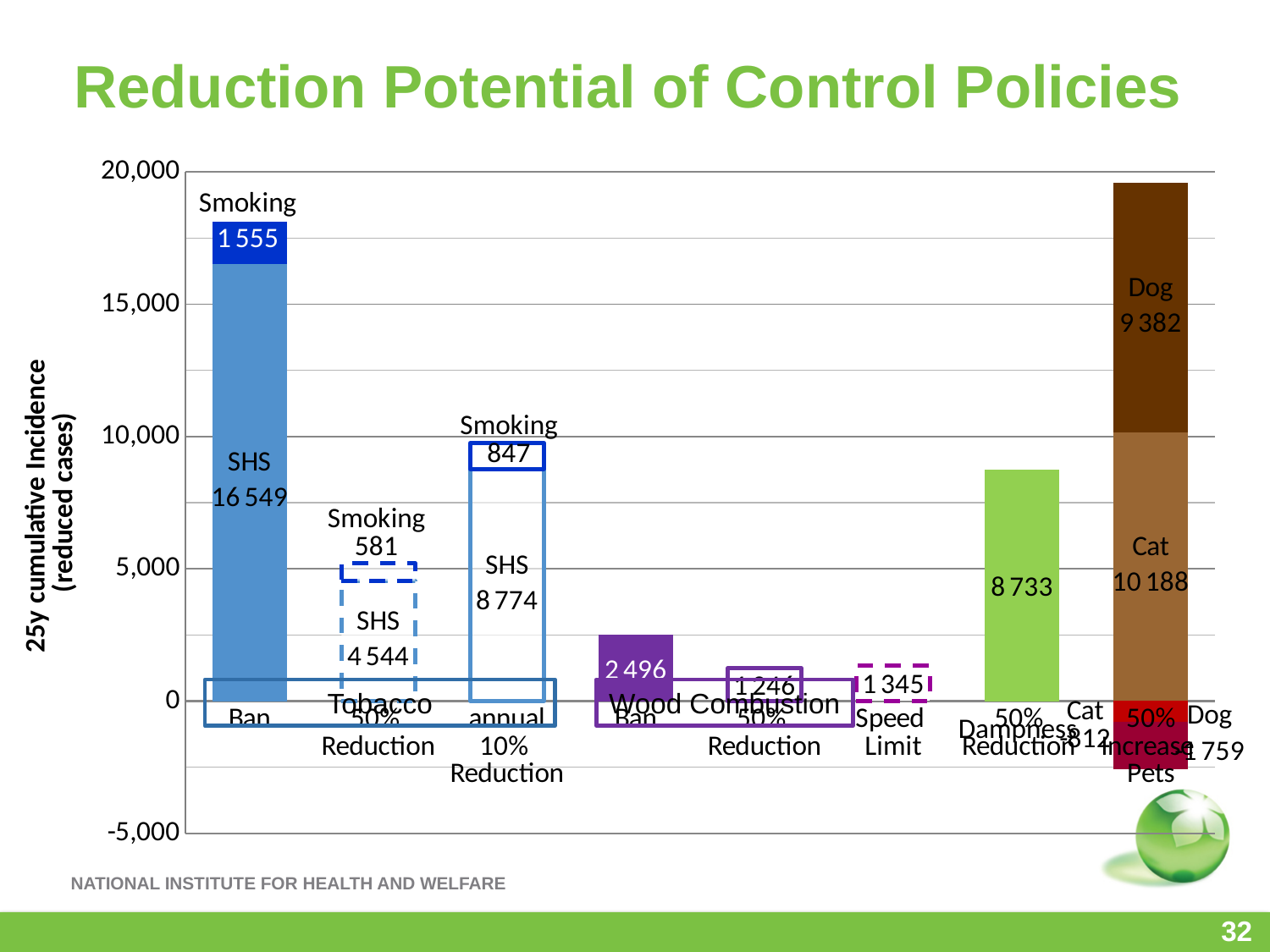
Is the value for Dampness 50% Reduction greater or less than 5,000? greater What is the difference between the SHS value for Tobacco Ban and the SHS value for Tobacco annual 10% Reduction? 7 775 What is the Smoking value for the Tobacco Ban bar? 1 555 What is the value for Dampness 50% Reduction? 8 733 What is the Smoking value for the Tobacco annual 10% Reduction bar? 847 What is the SHS value for the Tobacco Ban bar? 16 549 What is the value for the Wood Combustion Ban? 2 496 What kind of chart is shown on the slide? bar chart What is the total of the stacked Tobacco Ban bar (SHS plus Smoking)? 18 104 Which is larger, the value for Wood Combustion Ban or the value for Speed Limit? Wood Combustion Ban What is the value for Speed Limit? 1 345 What is the Cat value in the positive part of the Pets 50% Increase bar? 10 188